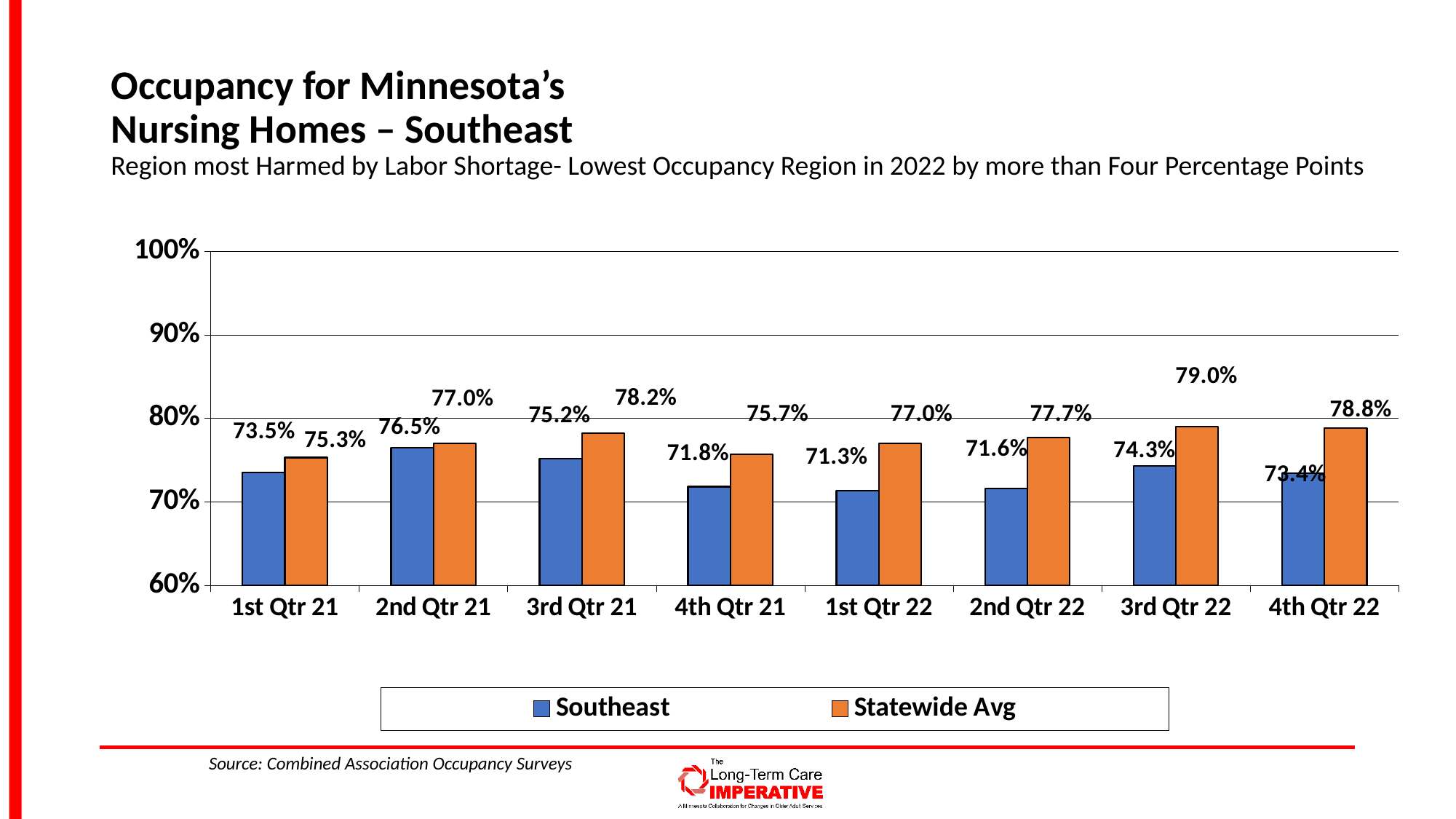
How many quarters are shown on the x axis? 8 What is the Southeast occupancy value for 2nd Qtr 21? 76.5% In which quarter is the Southeast occupancy lowest? 1st Qtr 22 How many series does the legend list? 2 In 1st Qtr 21, which is larger: the Southeast value or the Statewide Avg value? Statewide Avg What is the Southeast occupancy value for 1st Qtr 22? 71.3% What is the difference between the Statewide Avg and Southeast values in 4th Qtr 21? 3.9 percentage points What is the Statewide Avg occupancy value for 3rd Qtr 22? 79.0% What kind of chart is shown on the slide? Bar chart What is the difference between the Statewide Avg and Southeast values in 3rd Qtr 22? 4.7 percentage points In which quarter is the Statewide Avg occupancy highest? 3rd Qtr 22 In which quarter is the Southeast occupancy highest? 2nd Qtr 21